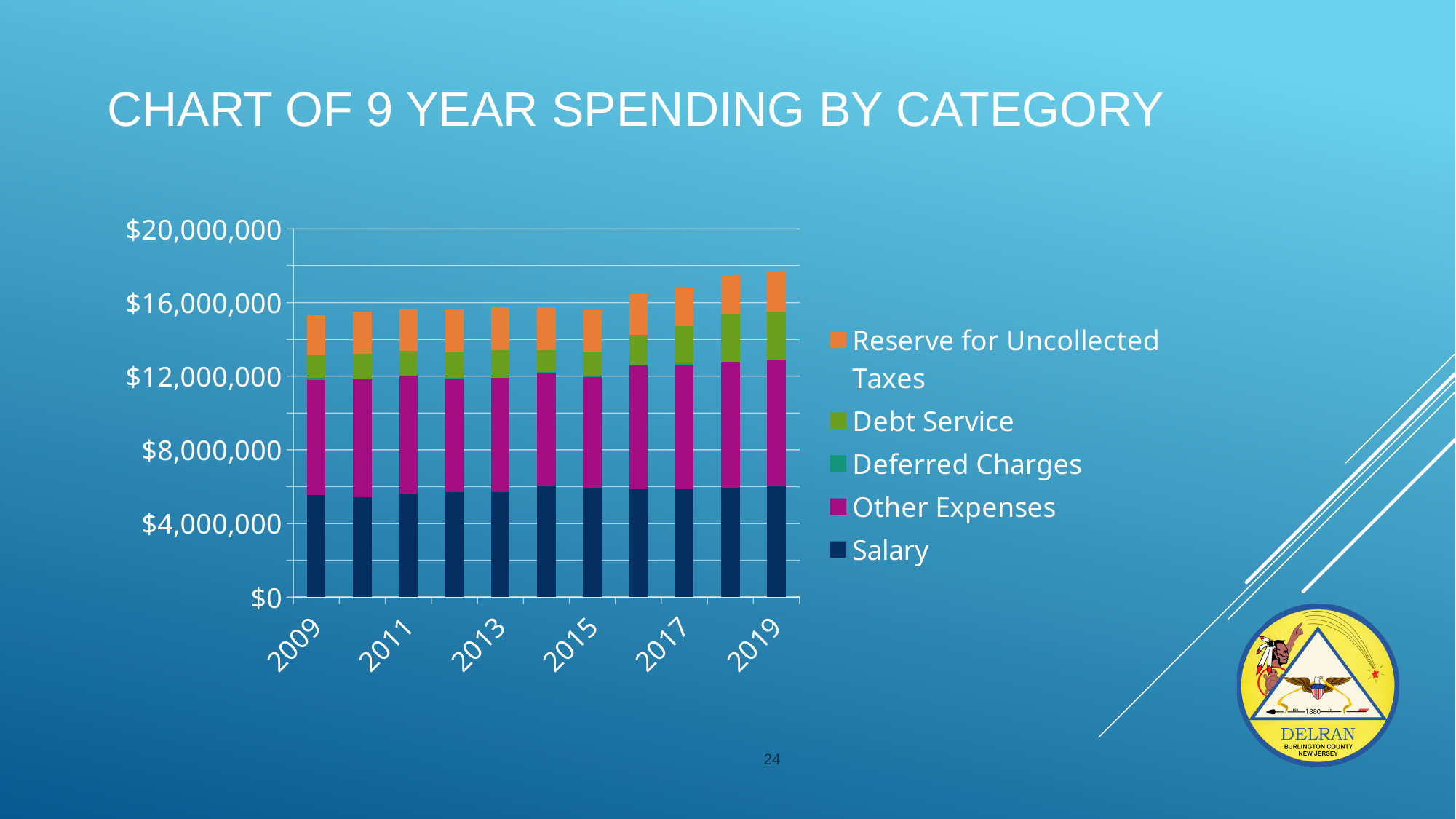
Which series is shown in orange in the legend? Reserve for Uncollected Taxes Is the total spending for 2019 greater or less than $16,000,000? greater How many years (bars) are plotted in the chart? 11 What kind of chart is shown on the slide? Stacked bar chart Is the Salary value for 2019 greater or less than $8,000,000? less Which year has the larger total spending, 2009 or 2019? 2019 Do the total spending values generally rise or fall from 2009 to 2019? rise Which series is shown at the bottom of each stacked bar? Salary Is the Salary value for 2009 greater or less than $4,000,000? greater How many series does the legend list? 5